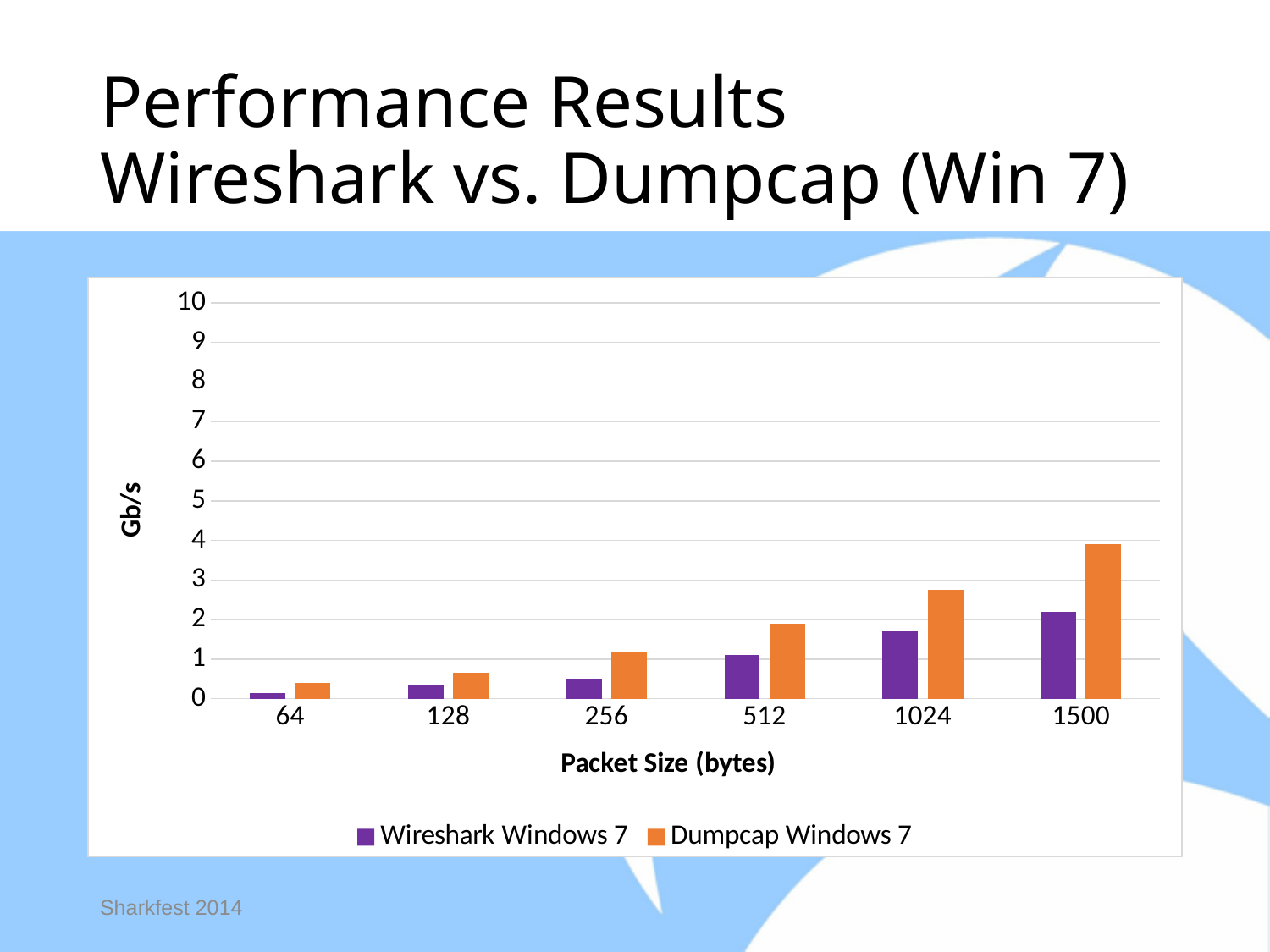
Which packet size has the highest Dumpcap Windows 7 value? 1500 Is the Wireshark Windows 7 value at 64 bytes greater or less than 1? less How many packet size categories are shown on the x axis? 6 Is the Dumpcap Windows 7 value at 1024 bytes greater or less than 3? less Do the Dumpcap Windows 7 values rise or fall as packet size increases along the x axis? rise Is the Wireshark Windows 7 value at 1024 bytes greater or less than 2? less What type of chart is shown on the slide? bar chart At a packet size of 1500 bytes, which series has the larger value, Wireshark Windows 7 or Dumpcap Windows 7? Dumpcap Windows 7 How many series does the legend list? 2 Which packet size has the lowest Wireshark Windows 7 value? 64 What is the label on the y axis? Gb/s